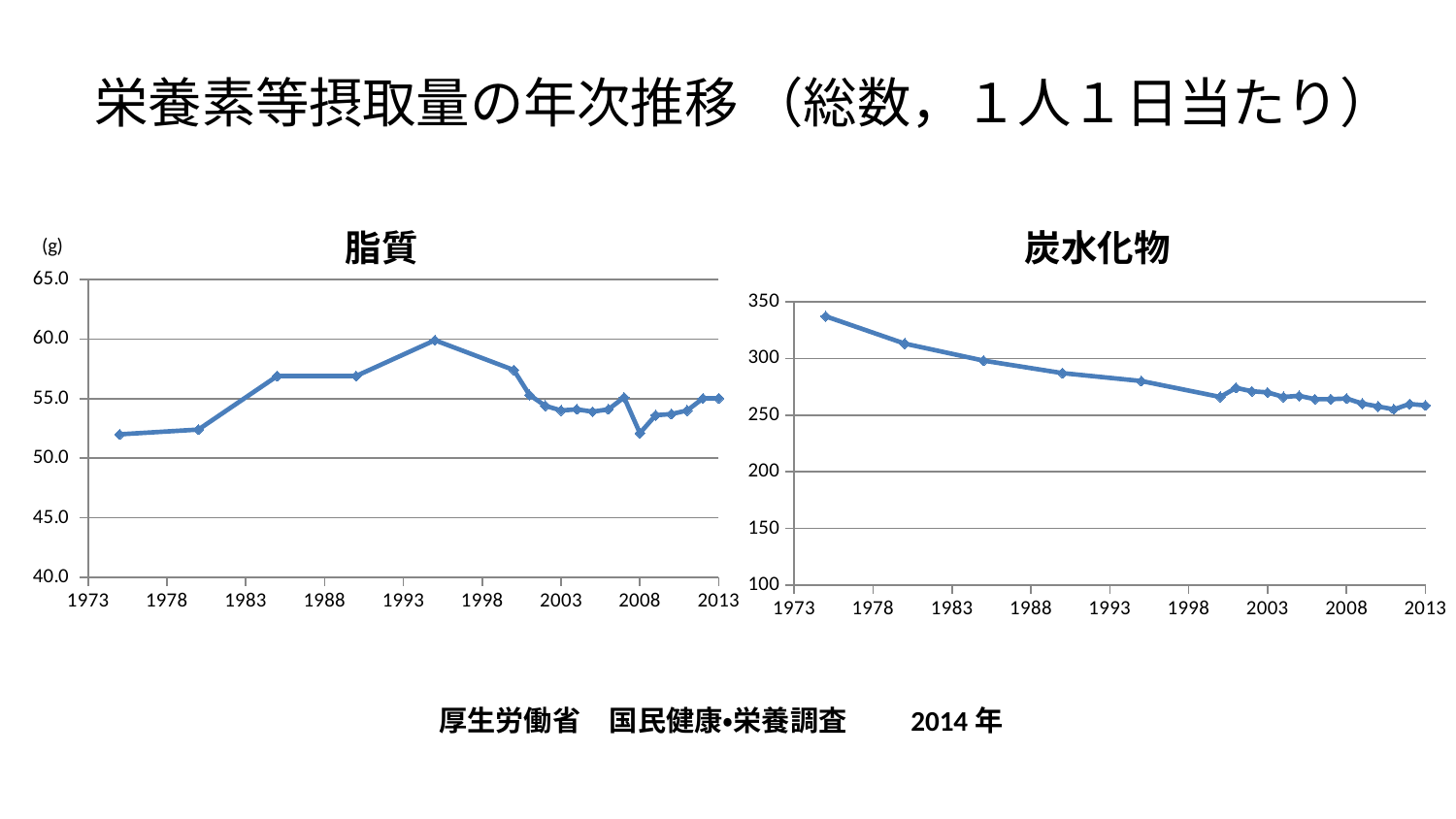
What kind of chart is the 脂質 chart? line chart In the 脂質 chart, does the line rise or fall between 1975 and 1995? rise In the 炭水化物 chart, is the value for 1975 greater or less than 300? greater How many charts are shown on the slide? 2 In the 脂質 chart, around which year does the line reach its highest value? 1995 What kind of chart is the 炭水化物 chart? line chart In the 脂質 chart, is the value for 1975 greater or less than 55.0? less In the 脂質 chart, is the value around 1995 greater or less than 55.0? greater In the 炭水化物 chart, do the values generally rise or fall from 1973 to 2013? fall In the 炭水化物 chart, which year has the highest value? 1975 What unit is shown on the y axis of the 脂質 chart? g